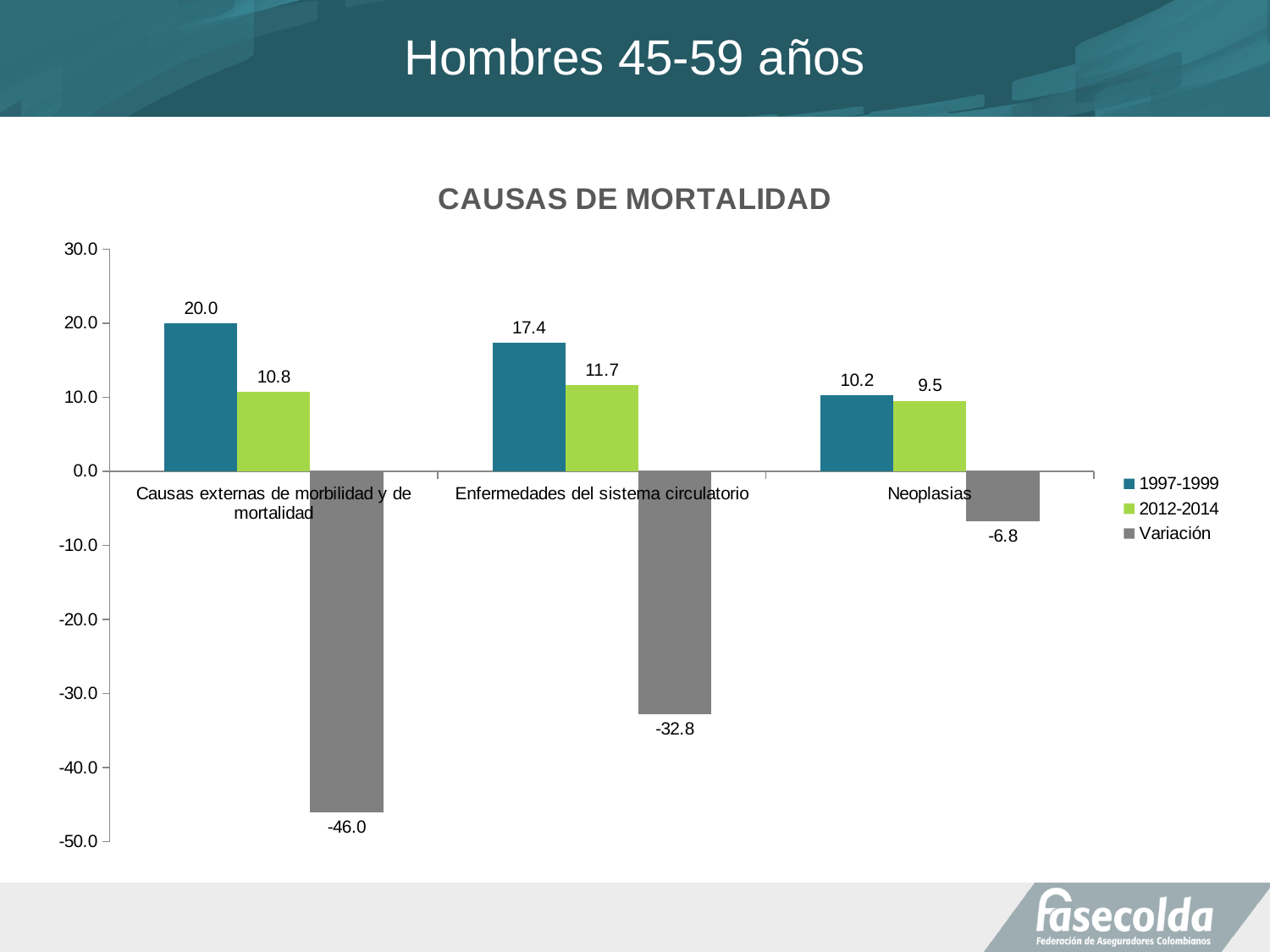
Which category has the lowest Variación value? Causas externas de morbilidad y de mortalidad What is the title of the chart? CAUSAS DE MORTALIDAD How many categories are shown on the x axis? 3 What is the 1997-1999 value for Causas externas de morbilidad y de mortalidad? 20.0 Is the Variación value for Enfermedades del sistema circulatorio greater or less than -30.0? less What is the difference between the 1997-1999 and 2012-2014 values for Causas externas de morbilidad y de mortalidad? 9.2 Which category has the highest 1997-1999 value? Causas externas de morbilidad y de mortalidad What is the Variación value for Neoplasias? -6.8 What is the 2012-2014 value for Enfermedades del sistema circulatorio? 11.7 How many series does the legend list? 3 Which is larger for Neoplasias: the 1997-1999 value or the 2012-2014 value? 1997-1999 What kind of chart is shown? bar chart